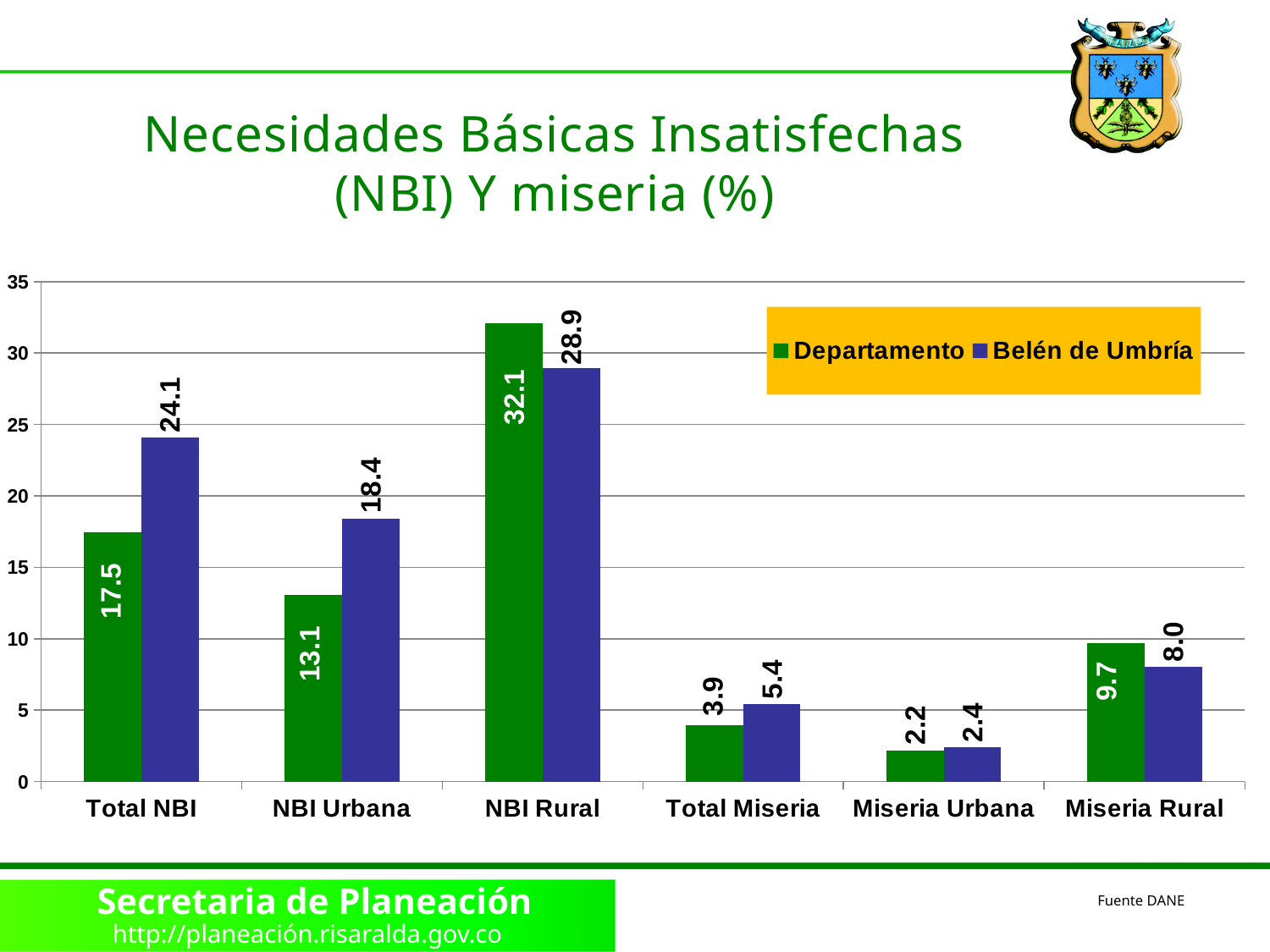
What is the Departamento value for Total NBI? 17.5 What is the difference between the Belén de Umbría and Departamento values for Total NBI? 6.6 For NBI Rural, which series has the larger value, Departamento or Belén de Umbría? Departamento What is the Belén de Umbría value for Miseria Urbana? 2.4 Which category has the lowest Belén de Umbría value? Miseria Urbana What kind of chart is shown on the slide? Bar chart For Miseria Rural, which series has the larger value, Departamento or Belén de Umbría? Departamento How many series does the legend list? 2 What is the Belén de Umbría value for NBI Rural? 28.9 Which category has the highest Departamento value? NBI Rural What colour are the Belén de Umbría bars? Blue How many categories are shown on the x axis? 6